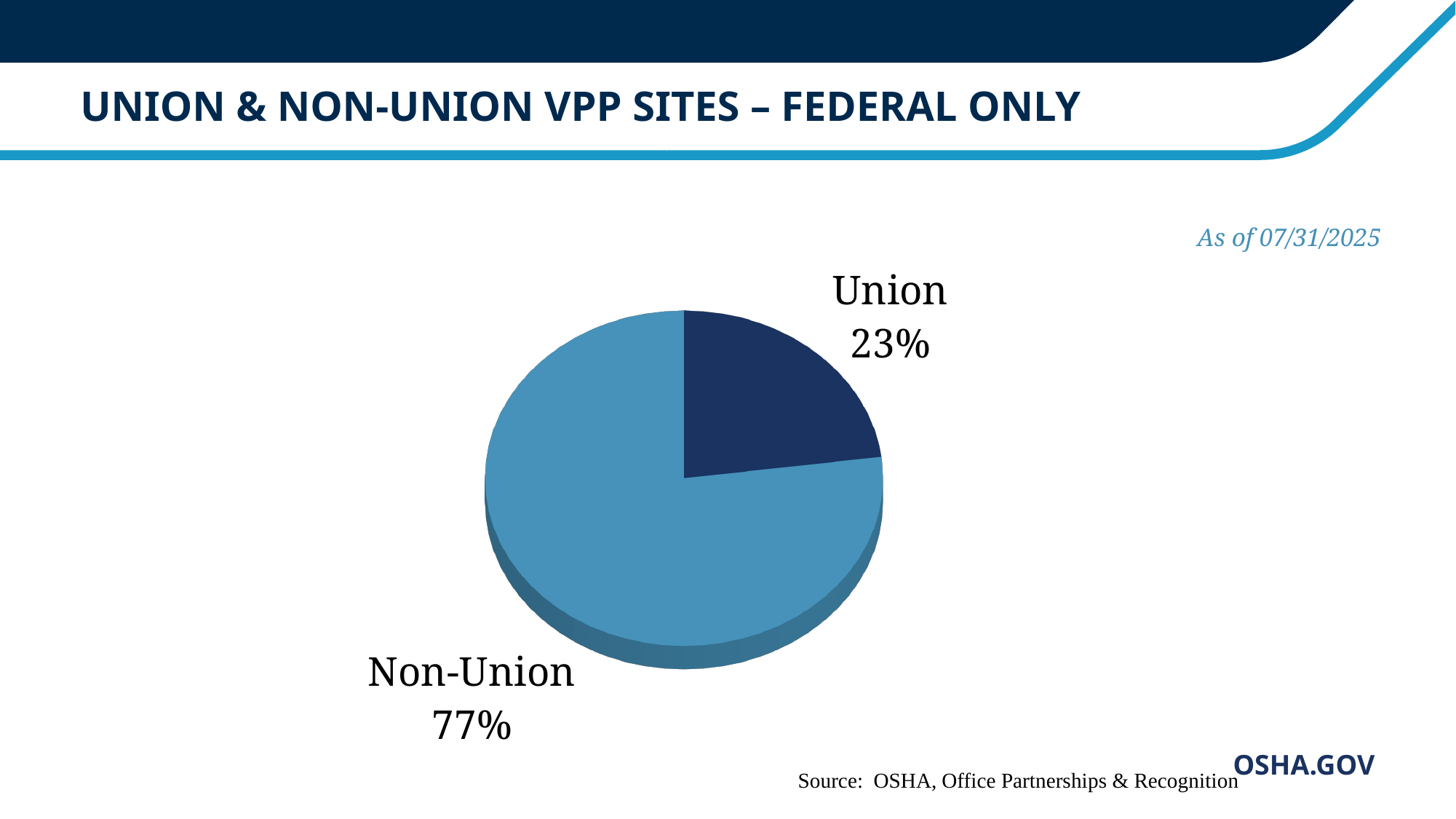
What share of the pie does the Union slice represent? 23% What kind of chart is shown on the slide? Pie chart Which is larger, the Union slice or the Non-Union slice? Non-Union What share of the pie does the Non-Union slice represent? 77% What is the title of the chart on the slide? UNION & NON-UNION VPP SITES – FEDERAL ONLY How many slices does the pie chart have? 2 What is the difference in percentage points between the Non-Union and Union slices? 54 Which category has the largest slice of the pie? Non-Union Which category has the smallest slice of the pie? Union What colour is the Union slice of the pie? Dark navy blue